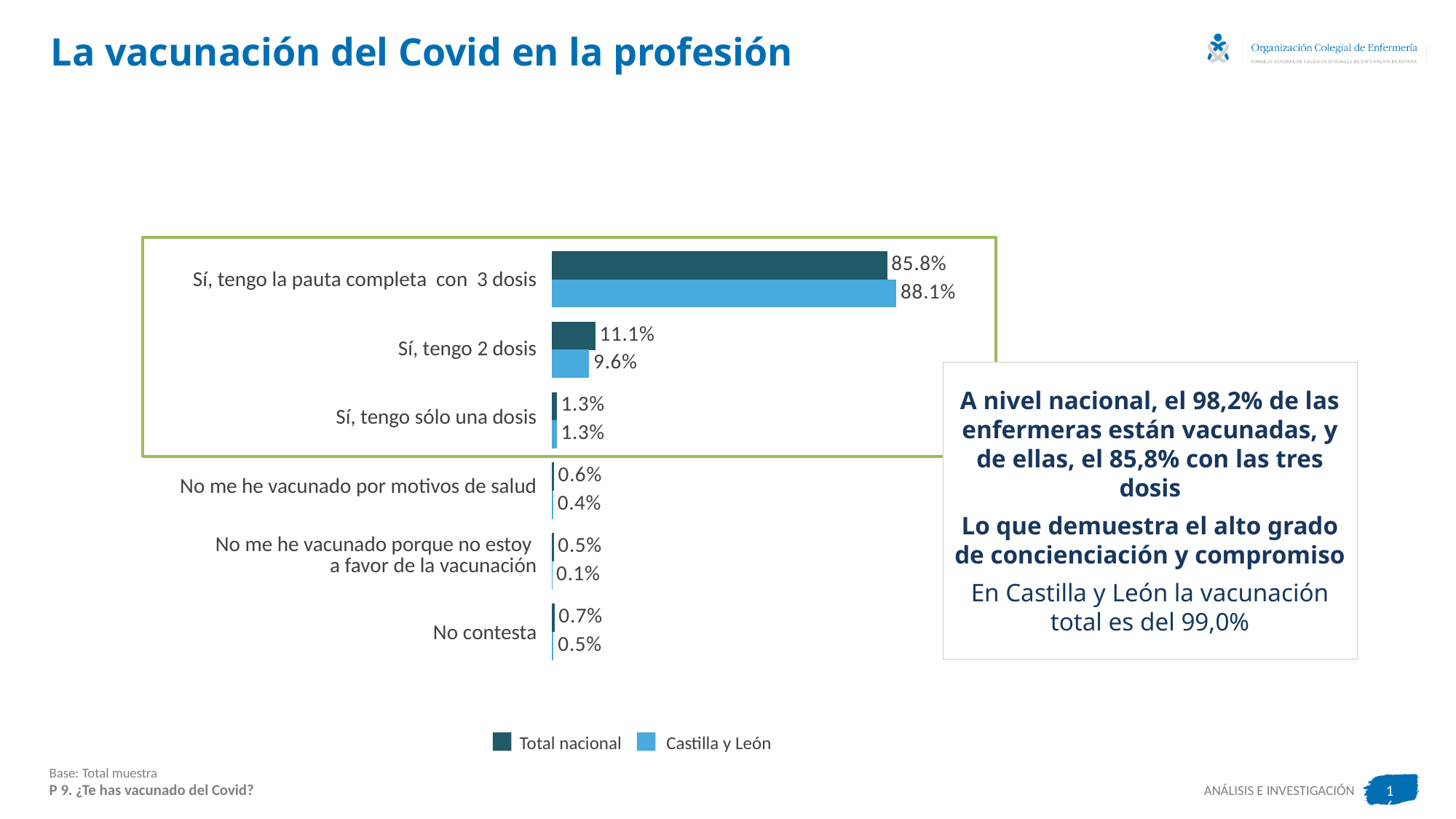
For 'Sí, tengo 2 dosis', which series has the larger value, Total nacional or Castilla y León? Total nacional What is the Castilla y León value for 'No me he vacunado porque no estoy a favor de la vacunación'? 0.1% What is the Total nacional value for 'Sí, tengo la pauta completa con 3 dosis'? 85.8% Which category has the highest Castilla y León value? Sí, tengo la pauta completa con 3 dosis What are the two series named in the legend? Total nacional and Castilla y León What is the difference between the Castilla y León and Total nacional values for 'Sí, tengo la pauta completa con 3 dosis'? 2.3% Which category has the lowest Castilla y León value? No me he vacunado porque no estoy a favor de la vacunación How many categories are shown in the chart? 6 How many series does the legend list? 2 What is the Castilla y León value for 'Sí, tengo 2 dosis'? 9.6% What is the Total nacional value for 'No contesta'? 0.7% What kind of chart is shown on the slide? Bar chart